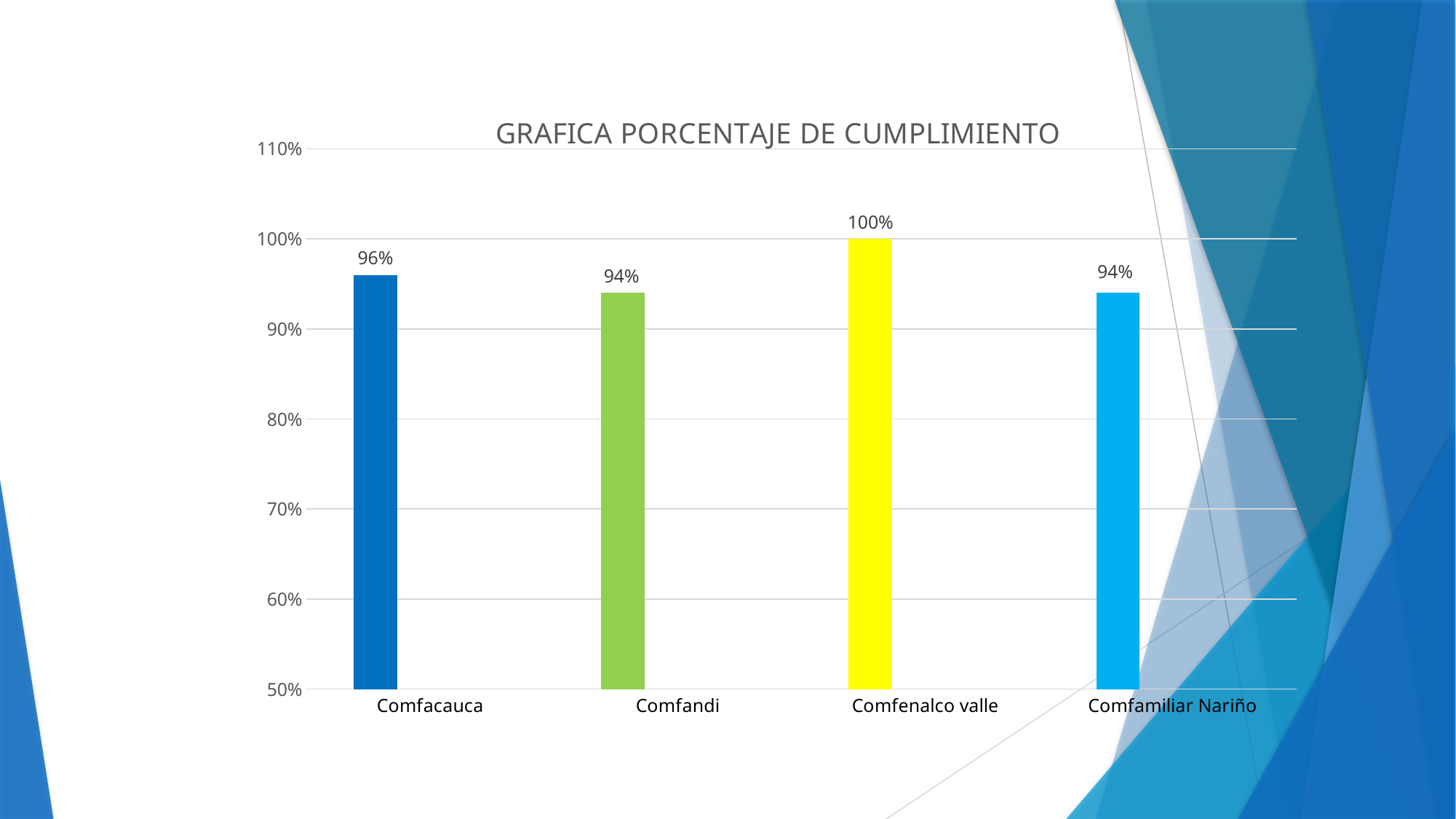
What is the value for Comfenalco valle? 100% What kind of chart is shown on the slide? bar chart What is the value for Comfandi? 94% What is the value for Comfamiliar Nariño? 94% Which is larger, the value for Comfacauca or the value for Comfandi? Comfacauca What is the difference between the values for Comfacauca and Comfandi? 2% What is the difference between the values for Comfenalco valle and Comfacauca? 4% Which category has the highest value? Comfenalco valle What is the value for Comfacauca? 96% Is the value for Comfandi greater or less than 90%? greater What is the title of the chart? GRAFICA PORCENTAJE DE CUMPLIMIENTO How many categories are shown in the chart? 4